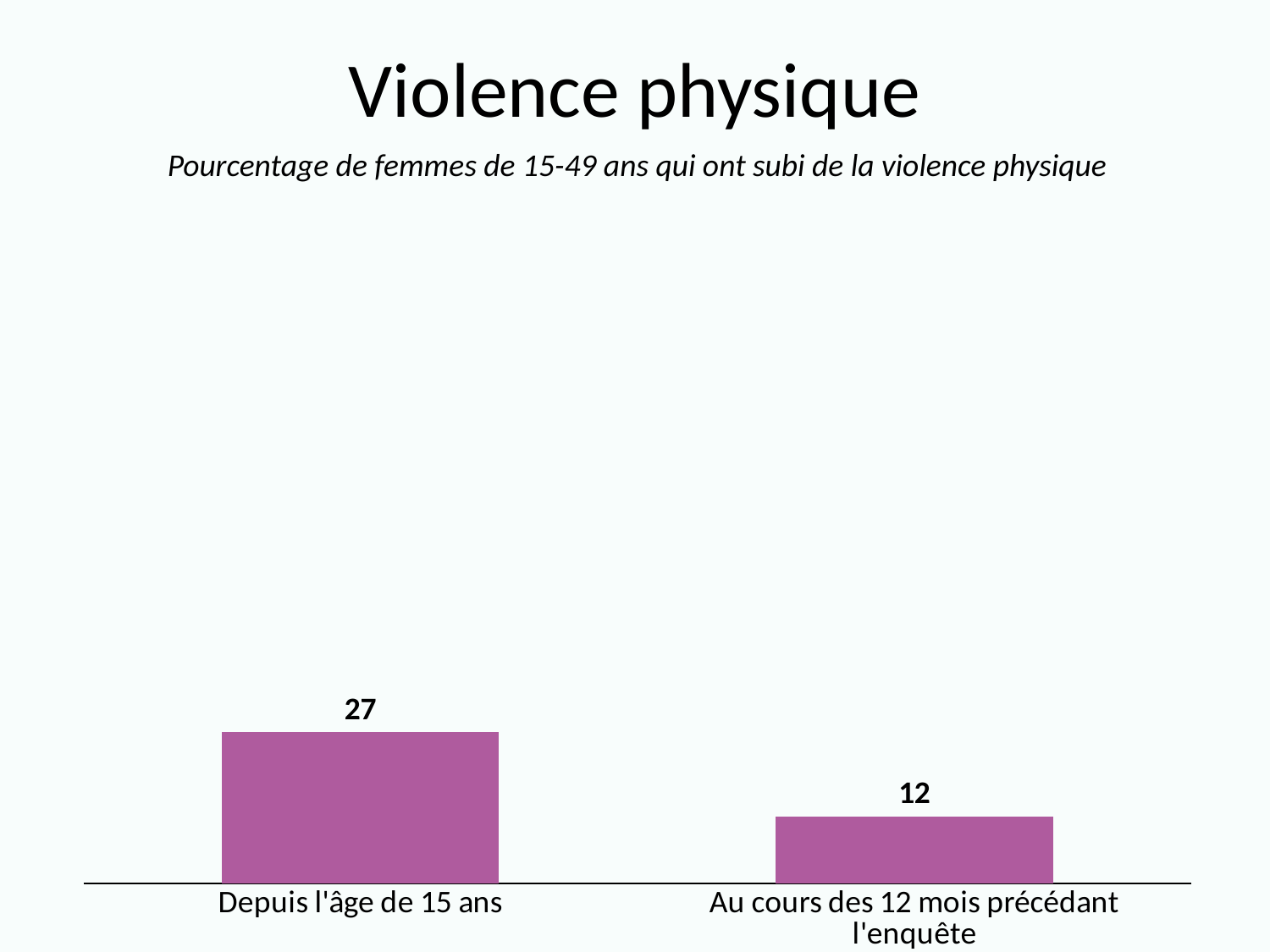
What colour are the bars in the chart? Purple How many categories are shown in the chart? 2 What is the value for "Depuis l'âge de 15 ans"? 27 Which category has the lowest value? Au cours des 12 mois précédant l'enquête What is the title of the slide? Violence physique Which category has the highest value? Depuis l'âge de 15 ans What kind of chart is shown on the slide? Bar chart What is the difference between the value for "Depuis l'âge de 15 ans" and the value for "Au cours des 12 mois précédant l'enquête"? 15 Which is larger: the value for "Depuis l'âge de 15 ans" or the value for "Au cours des 12 mois précédant l'enquête"? Depuis l'âge de 15 ans Do the values rise or fall from left to right across the categories? Fall What is the value for "Au cours des 12 mois précédant l'enquête"? 12